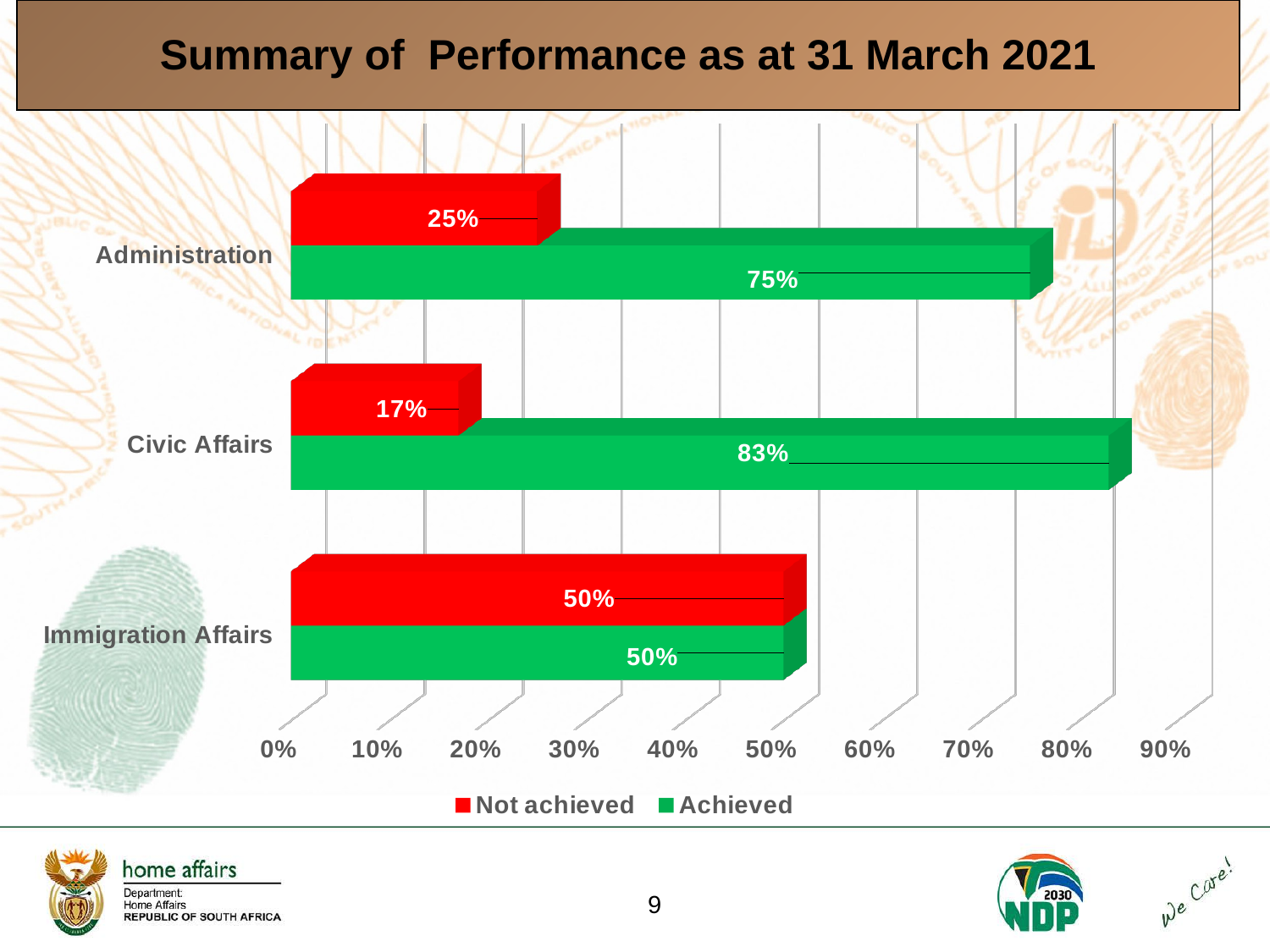
How many series does the legend list? 2 Which colour represents the Not achieved series? Red Which category has the lowest Not achieved value? Civic Affairs What is the Not achieved value for Civic Affairs? 17% What kind of chart is shown on the slide? Bar chart What is the Achieved value for Immigration Affairs? 50% Which category has the highest Achieved value? Civic Affairs How many categories are shown on the chart? 3 Which is larger for Administration: the Achieved value or the Not achieved value? Achieved What is the title of the chart? Summary of Performance as at 31 March 2021 What is the Achieved value for Administration? 75% What is the difference between the Achieved values for Civic Affairs and Administration? 8%